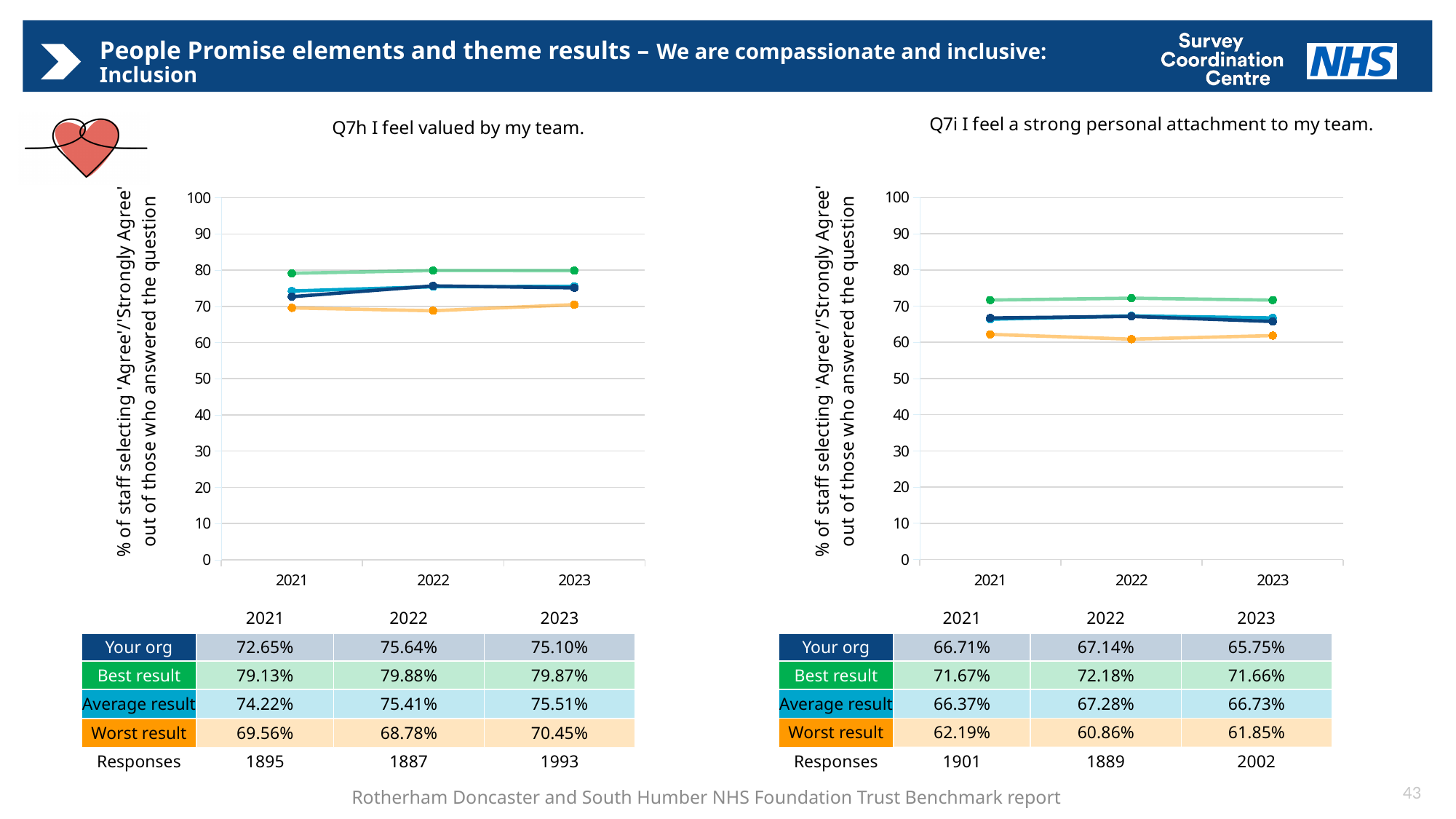
How many years are plotted on the x axis of the Q7h 'I feel valued by my team' chart? 3 What kind of chart is the Q7h 'I feel valued by my team' chart? line chart How many series are plotted in the Q7i 'I feel a strong personal attachment to my team' chart? 4 In the Q7h 'I feel valued by my team' chart, what is the value for Your org in 2022? 75.64% In the Q7i 'I feel a strong personal attachment to my team' chart, is the Your org value in 2022 larger or smaller than the Average result in 2022? smaller In the Q7i 'I feel a strong personal attachment to my team' chart, which year has the lowest Your org value? 2023 In the Q7i 'I feel a strong personal attachment to my team' chart, what is the Worst result value in 2022? 60.86% In the Q7i 'I feel a strong personal attachment to my team' chart, how many responses were there in 2023? 2002 In the Q7h 'I feel valued by my team' chart, what is the difference between the Best result and Worst result in 2023? 9.42% In the Q7h 'I feel valued by my team' chart, which year has the highest Best result value? 2022 In the Q7h 'I feel valued by my team' chart, does the Average result rise or fall from 2021 to 2023? rise In the Q7h 'I feel valued by my team' chart, is the Worst result value for 2022 greater or less than 70? less